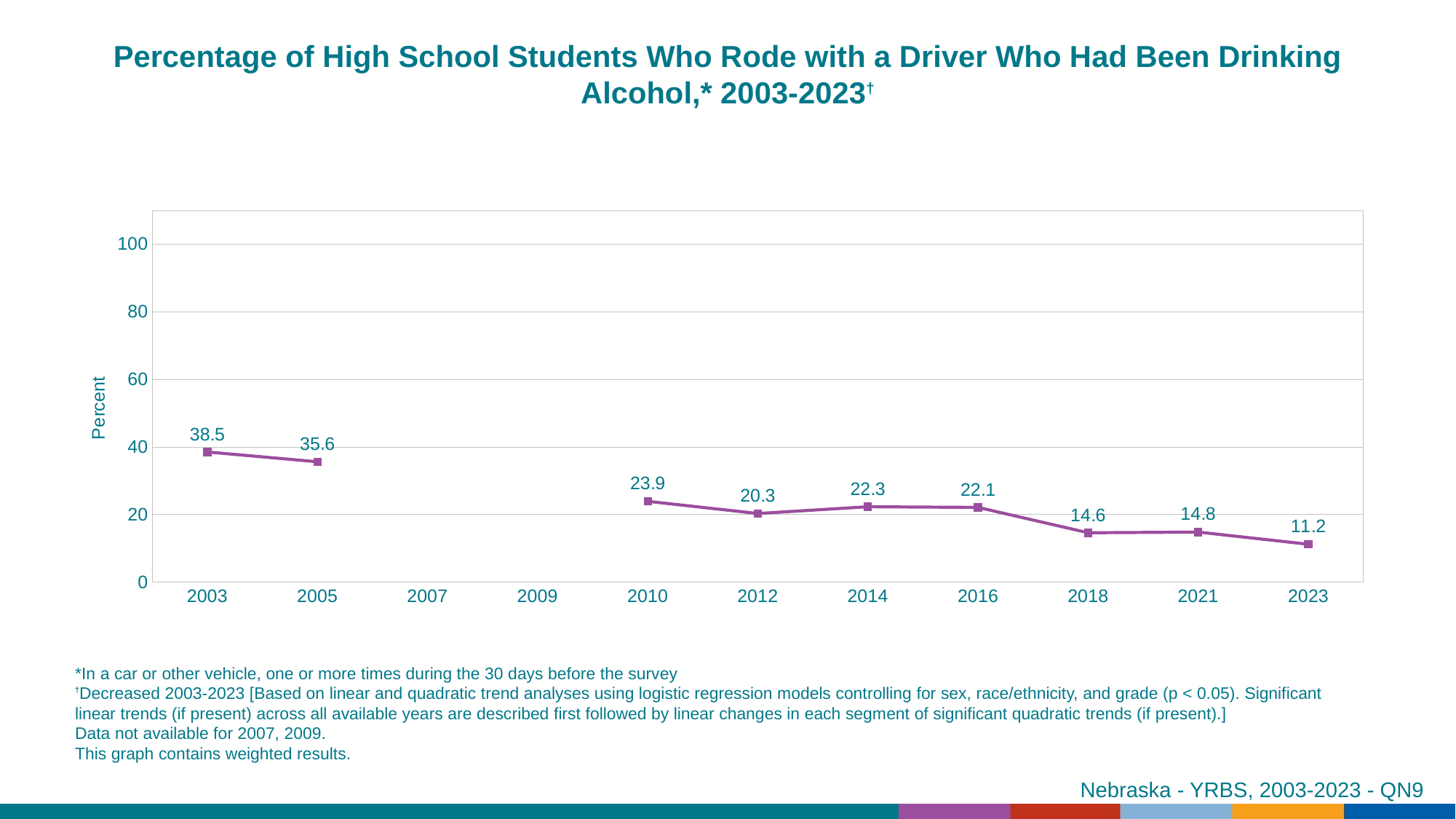
Which years are listed on the x axis but have no data plotted? 2007 and 2009 Do the values generally rise or fall from 2003 to 2023? fall Is the value for 2005 greater or less than 40? less Which is larger, the value for 2010 or the value for 2014? 2010 Which year has the lowest value? 2023 What is the difference between the values for 2003 and 2023? 27.3 What is the value for 2003? 38.5 What is the value for 2023? 11.2 How many years have a plotted data point? 9 Which year has the highest value? 2003 What is the value for 2012? 20.3 What kind of chart is this? line chart